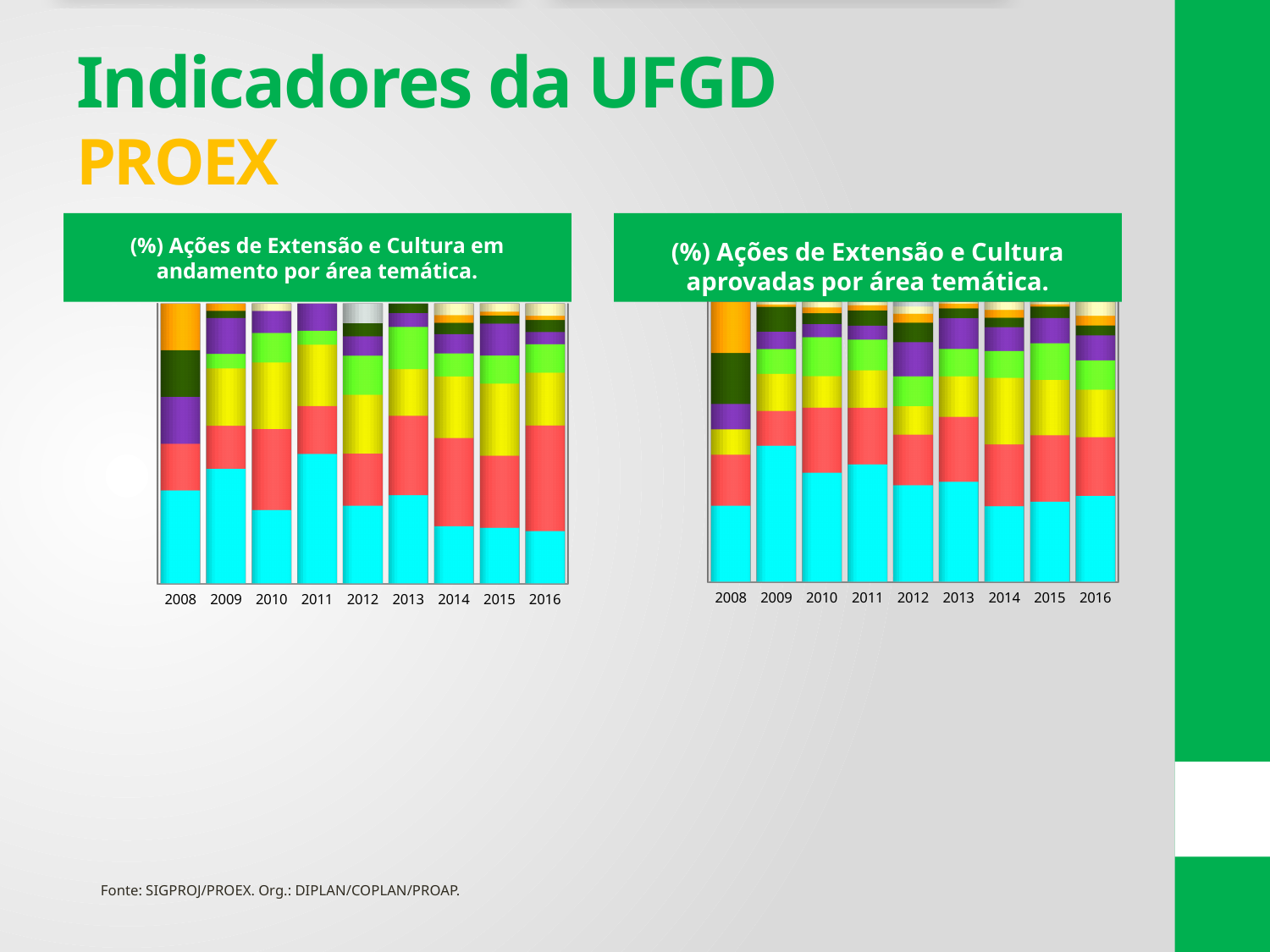
In the right chart, '(%) Ações de Extensão e Cultura aprovadas por área temática', is the bottom (cyan) segment larger in 2009 or in 2016? 2009 What type of chart is the left chart, '(%) Ações de Extensão e Cultura em andamento por área temática'? stacked bar chart In the left chart, '(%) Ações de Extensão e Cultura em andamento por área temática', which year has the largest bottom (cyan) segment? 2011 How many years are shown on the x axis of the left chart, '(%) Ações de Extensão e Cultura em andamento por área temática'? 9 In the left chart, '(%) Ações de Extensão e Cultura em andamento por área temática', is the bottom (cyan) segment larger in 2011 or in 2010? 2011 What type of chart is the right chart, '(%) Ações de Extensão e Cultura aprovadas por área temática'? stacked bar chart How many years are shown on the x axis of the right chart, '(%) Ações de Extensão e Cultura aprovadas por área temática'? 9 What is the last year shown on the x axis of the right chart? 2016 What is the first year shown on the x axis of the left chart? 2008 In the right chart, '(%) Ações de Extensão e Cultura aprovadas por área temática', which year has the largest bottom (cyan) segment? 2009